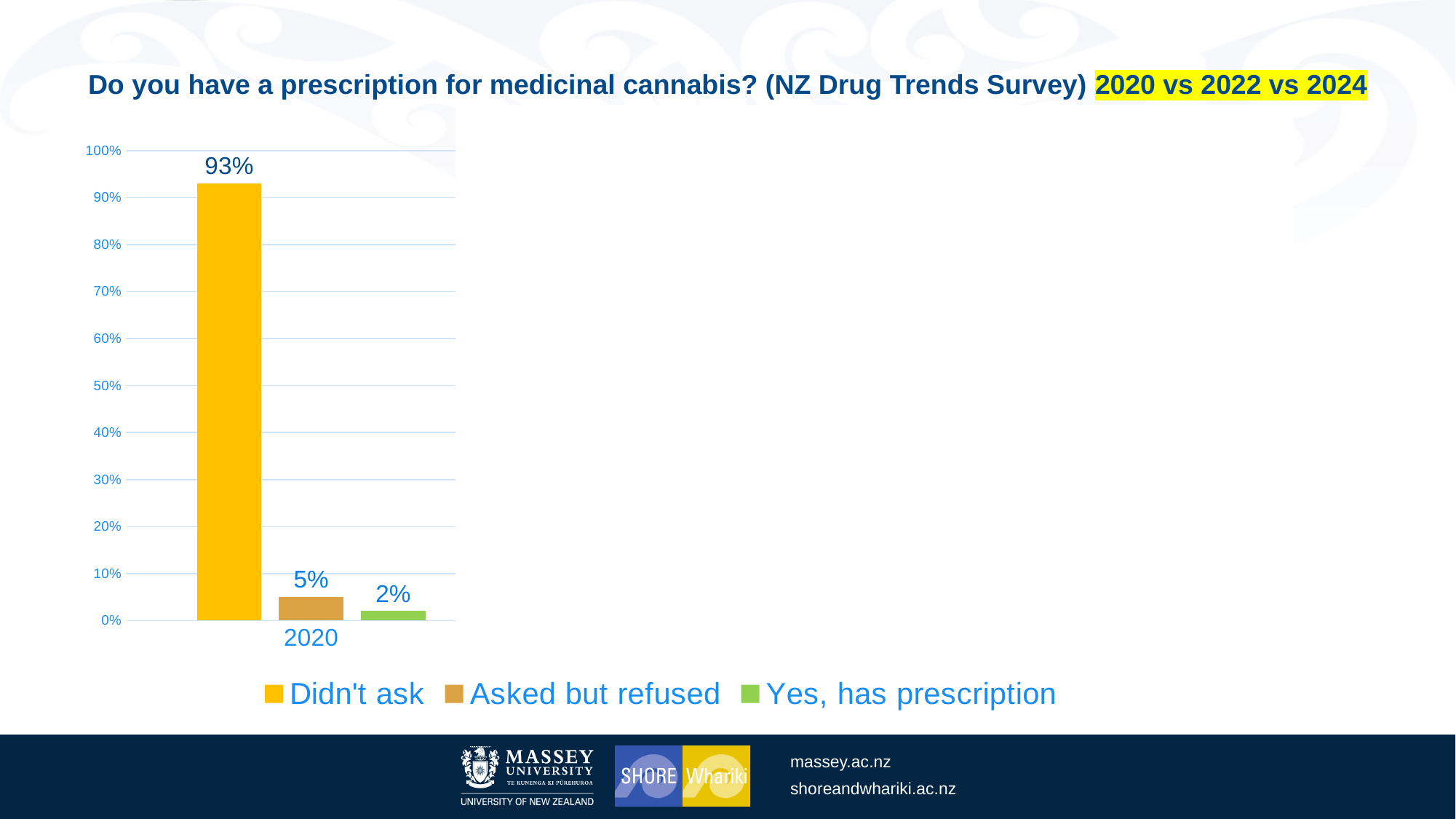
What is the difference between the 'Didn't ask' and 'Asked but refused' percentages in 2020? 88% What percentage of respondents in 2020 said yes, they have a prescription? 2% What kind of chart is shown on the slide? Bar chart Which response had the highest percentage in 2020? Didn't ask Which is larger in 2020: 'Asked but refused' or 'Yes, has prescription'? Asked but refused What percentage of respondents in 2020 said they didn't ask for a prescription? 93% What percentage of respondents in 2020 asked but were refused a prescription? 5% What is the difference between the 'Asked but refused' and 'Yes, has prescription' percentages in 2020? 3% Is the value for 'Didn't ask' in 2020 greater or less than 90%? greater Which year is labelled on the x axis of the chart? 2020 Which response had the lowest percentage in 2020? Yes, has prescription How many series does the legend list? 3